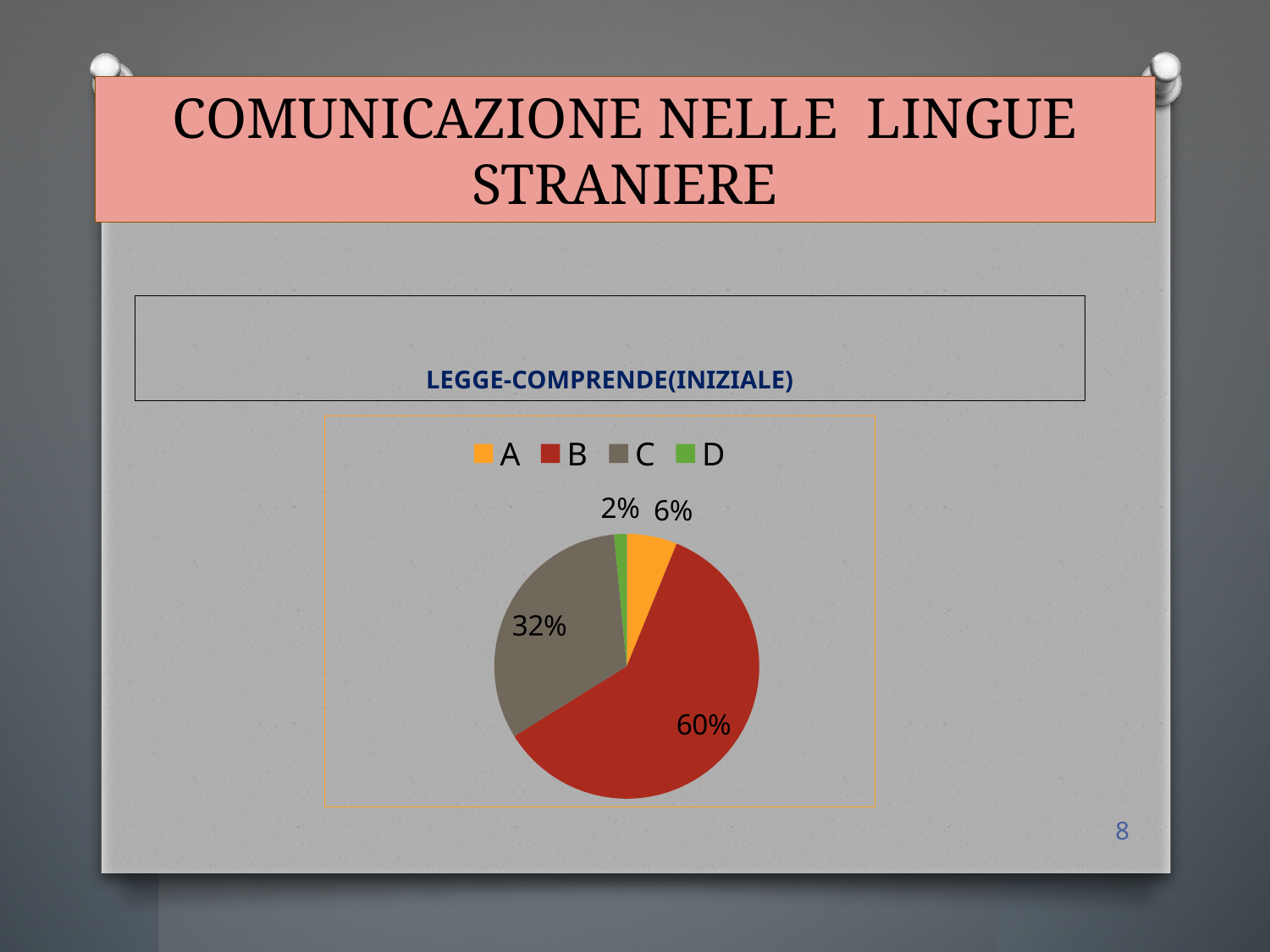
What share of the pie does category B have? 60% What share of the pie does category D have? 2% What share of the pie does category C have? 32% What is the title of the chart? LEGGE-COMPRENDE(INIZIALE) What is the difference between the shares of B and C? 28% Which category has the largest slice? B What kind of chart is shown on the slide? pie chart How many categories does the legend list? 4 Which is larger, the share of A or the share of D? A Which category has the smallest slice? D What colour is the slice for category C? grey